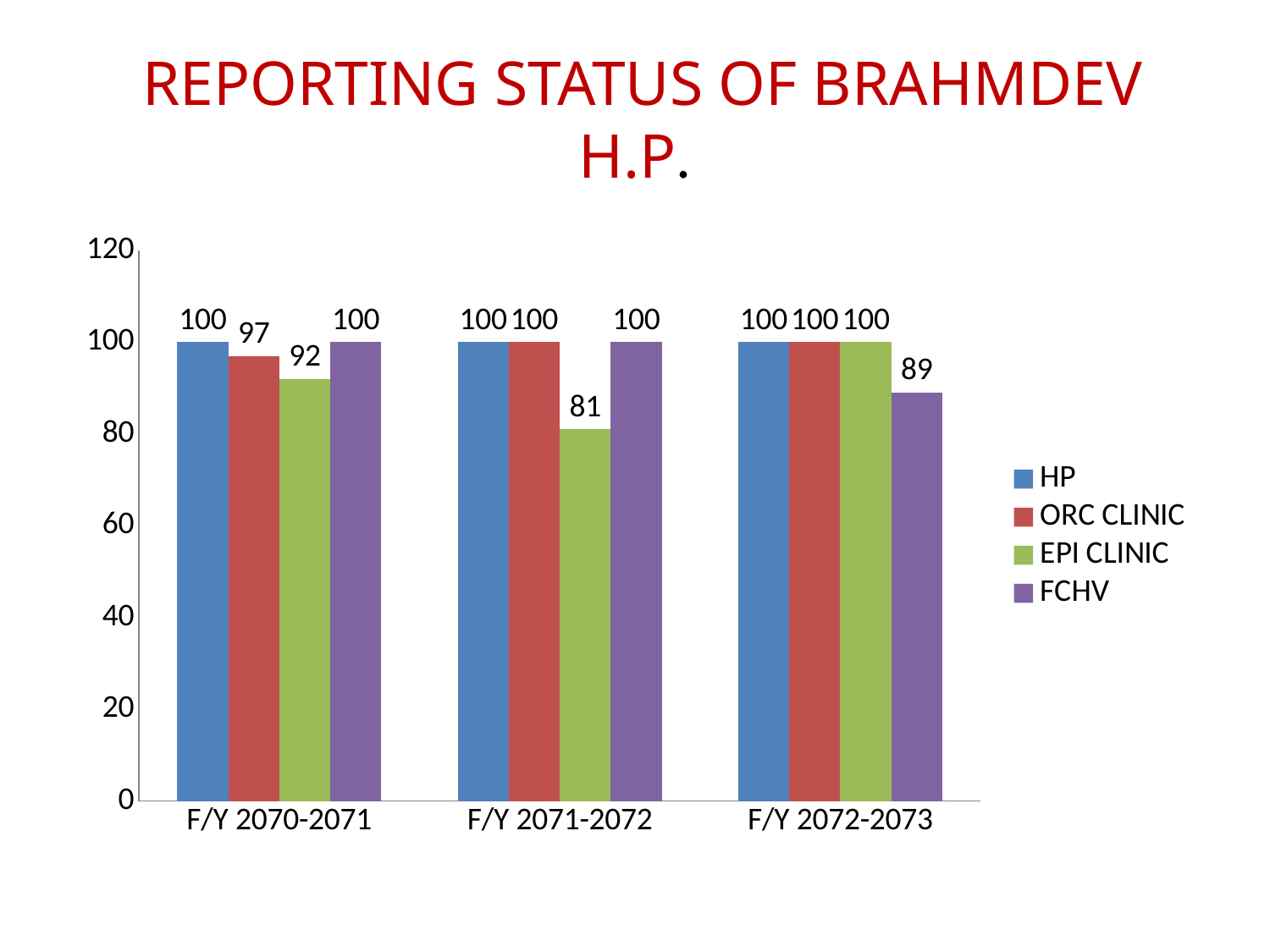
What is the value for FCHV in F/Y 2072-2073? 89 Which is larger: the EPI CLINIC value in F/Y 2070-2071 or the EPI CLINIC value in F/Y 2071-2072? F/Y 2070-2071 What is the difference between the HP value and the EPI CLINIC value in F/Y 2071-2072? 19 What is the value for ORC CLINIC in F/Y 2070-2071? 97 Does the EPI CLINIC value rise or fall from F/Y 2071-2072 to F/Y 2072-2073? Rise Which series has the lowest value in F/Y 2072-2073? FCHV What is the value for EPI CLINIC in F/Y 2070-2071? 92 How many fiscal year categories are shown on the x axis? 3 Which series has the lowest value in F/Y 2071-2072? EPI CLINIC How many series does the legend list? 4 What kind of chart is shown on the slide? Bar chart What is the value for EPI CLINIC in F/Y 2071-2072? 81